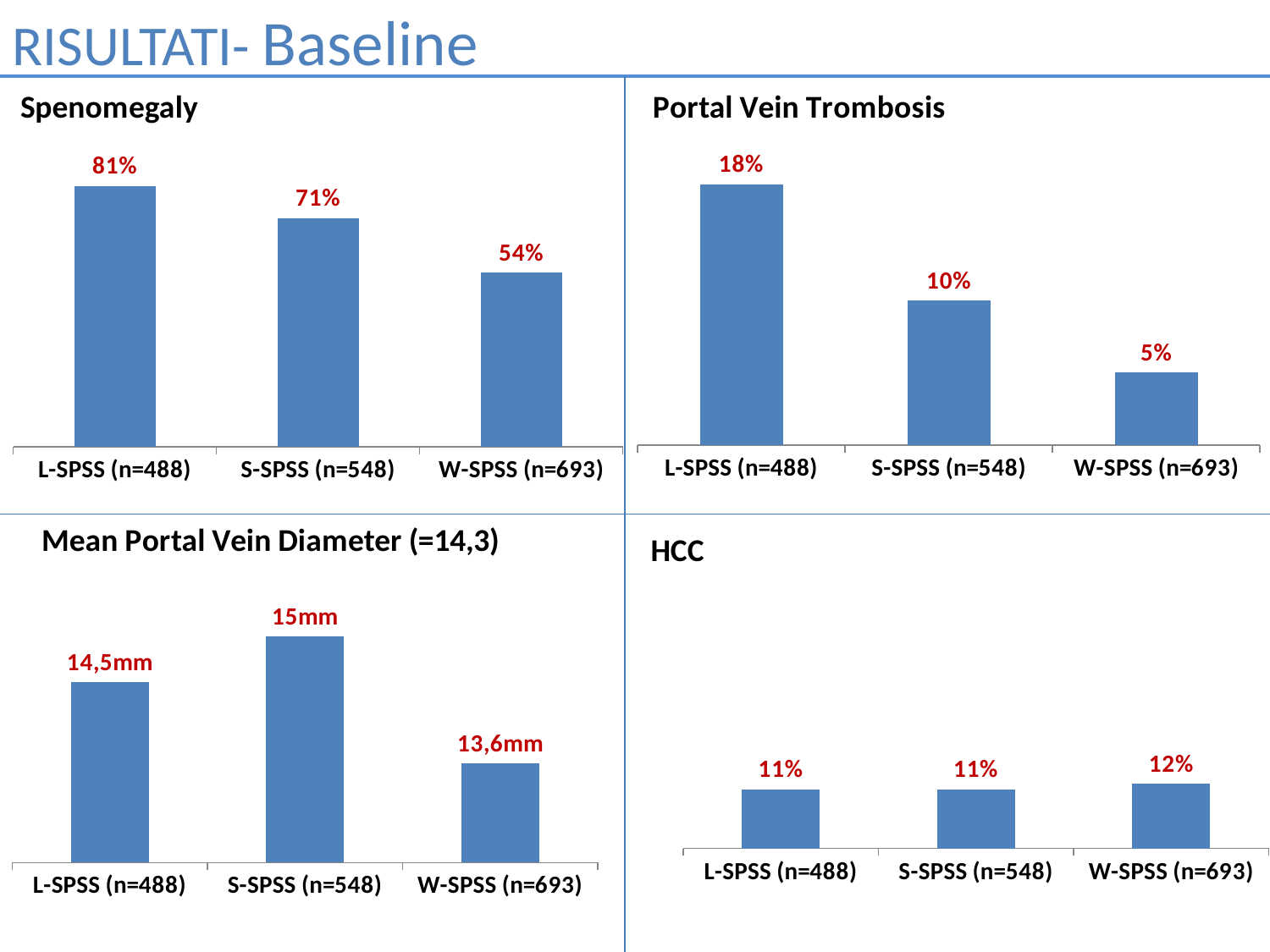
What kind of chart is the Spenomegaly chart? bar chart In the Spenomegaly chart, what is the difference between L-SPSS (n=488) and W-SPSS (n=693)? 27% In the Portal Vein Trombosis chart, which category has the highest value? L-SPSS (n=488) In the Spenomegaly chart, what is the value for L-SPSS (n=488)? 81% In the Mean Portal Vein Diameter (=14,3) chart, what is the value for W-SPSS (n=693)? 13,6mm In the Spenomegaly chart, which category has the lowest value? W-SPSS (n=693) In the Portal Vein Trombosis chart, what is the value for S-SPSS (n=548)? 10% In the Mean Portal Vein Diameter (=14,3) chart, which category has the highest value? S-SPSS (n=548) In the Mean Portal Vein Diameter (=14,3) chart, which is larger, L-SPSS (n=488) or W-SPSS (n=693)? L-SPSS (n=488) In the Portal Vein Trombosis chart, do the values rise or fall from left to right along the x axis? fall In the HCC chart, what is the value for W-SPSS (n=693)? 12% How many categories does the HCC chart show? 3